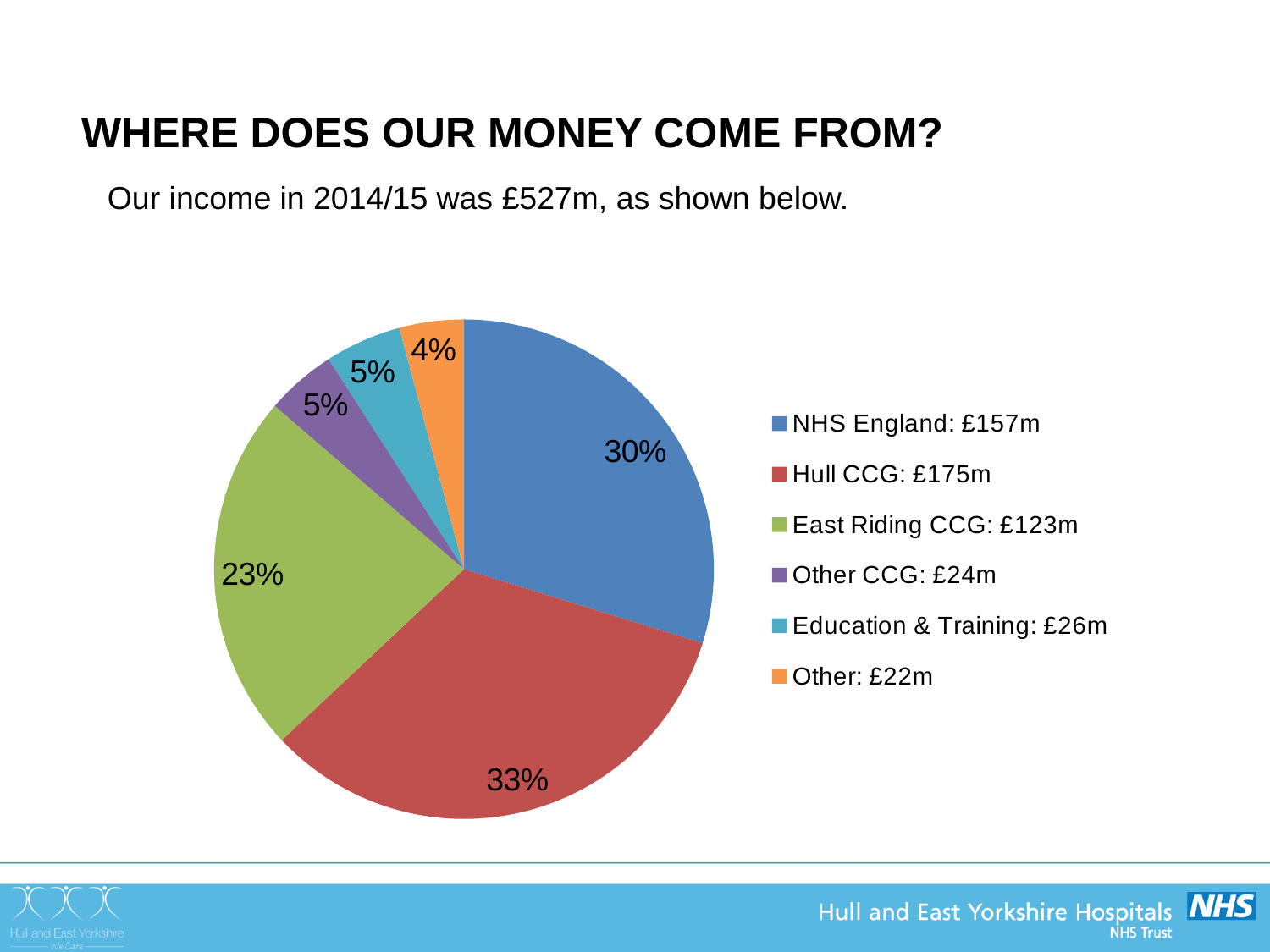
What kind of chart is shown on the slide? pie chart What is the difference between the Hull CCG income and the NHS England income? £18m Which income source is the largest slice of the pie? Hull CCG What share of the pie does East Riding CCG represent? 23% What share of the pie does Other represent? 4% What share of the pie does Hull CCG represent? 33% According to the legend, how much income came from Education & Training? £26m According to the legend, how much income came from Other CCG? £24m Which is larger, the income from East Riding CCG or from NHS England? NHS England Which income source is the smallest slice of the pie? Other How many income sources are shown in the pie chart? 6